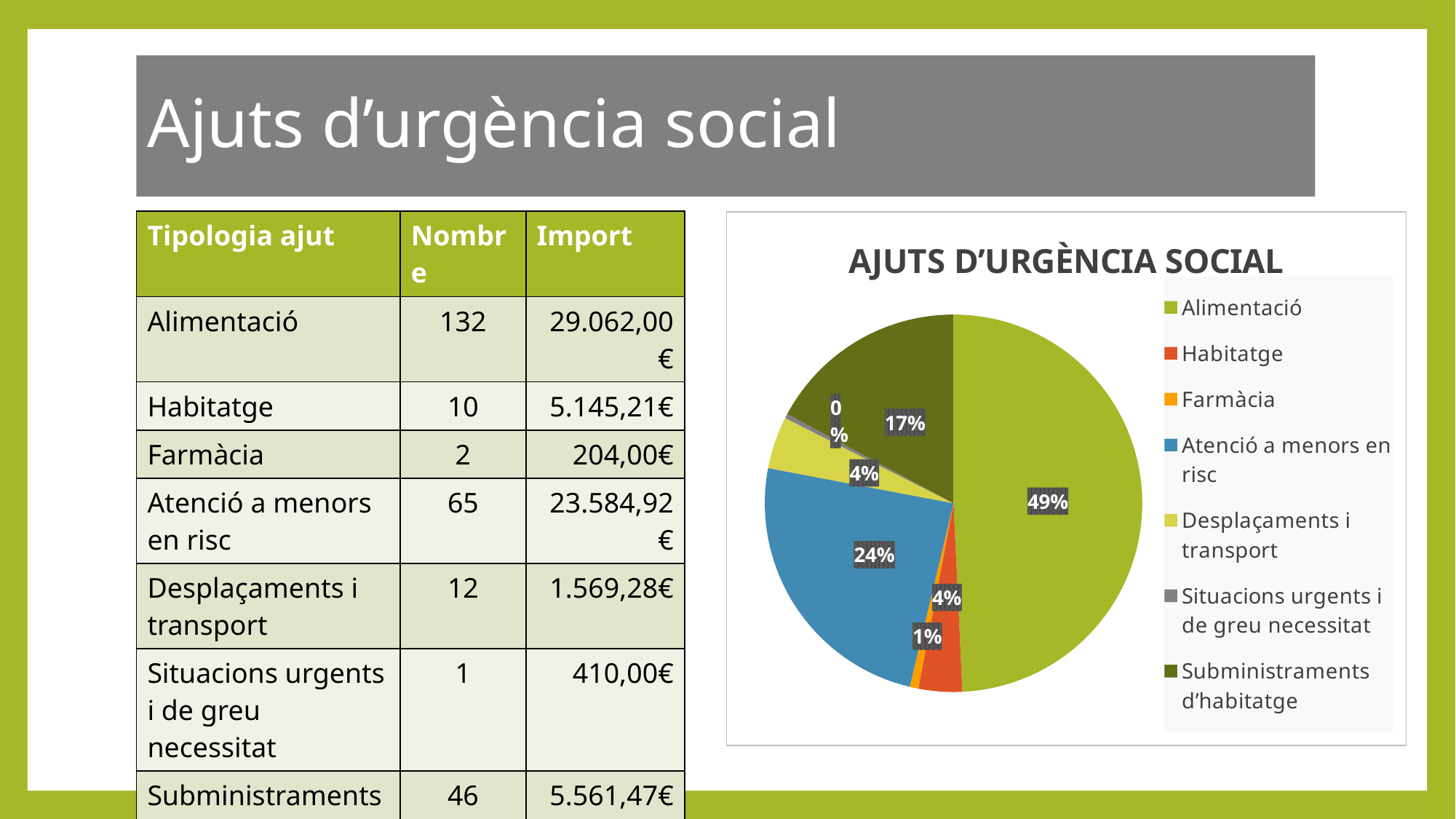
Which category has the largest slice in the pie chart? Alimentació What is the difference in percentage points between the Alimentació slice and the Atenció a menors en risc slice? 25 What percentage share does the Farmàcia slice have in the pie chart? 1% How many entries does the chart legend list? 7 What percentage share does the Subministraments d'habitatge slice have in the pie chart? 17% What is the title of the chart? AJUTS D'URGÈNCIA SOCIAL What type of chart is shown on the slide? pie chart Which slice is larger in the pie chart, Subministraments d'habitatge or Habitatge? Subministraments d'habitatge What percentage share does the Alimentació slice have in the pie chart? 49% Which category has the smallest slice in the pie chart? Situacions urgents i de greu necessitat